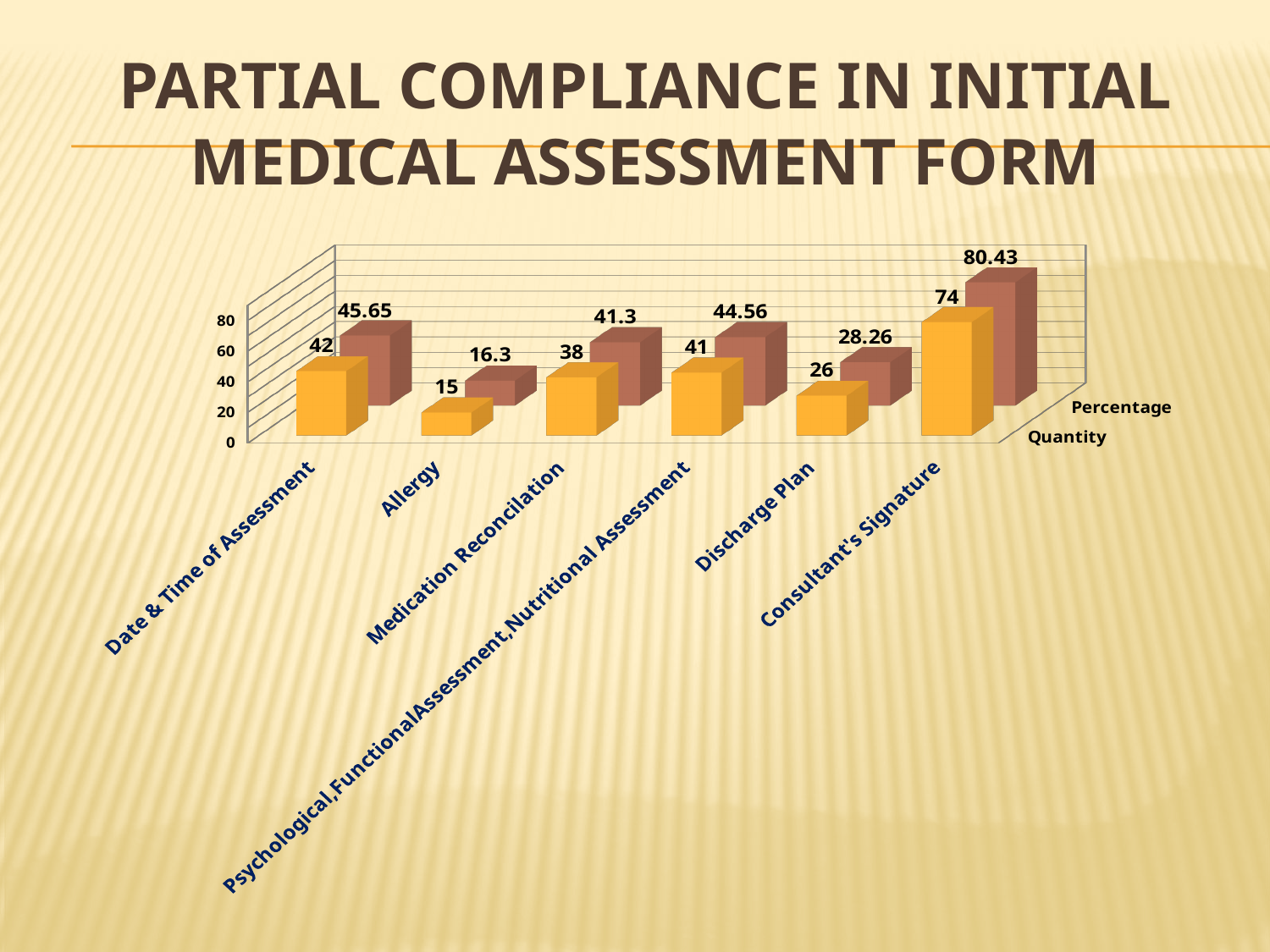
What is the Quantity value for Medication Reconcilation? 38 Which category has the highest Percentage value? Consultant's Signature What is the Quantity value for Consultant's Signature? 74 What is the title of the slide containing the chart? Partial Compliance in Initial Medical Assessment Form Which has a larger Quantity value, Date & Time of Assessment or Discharge Plan? Date & Time of Assessment Which category has the lowest Quantity value? Allergy What is the difference between the Quantity values for Consultant's Signature and Allergy? 59 What kind of chart is shown on the slide? Bar chart What is the difference between the Percentage values for Date & Time of Assessment and Discharge Plan? 17.39 What is the Percentage value for Discharge Plan? 28.26 How many categories are shown on the x axis of the chart? 6 What is the Percentage value for Allergy? 16.3